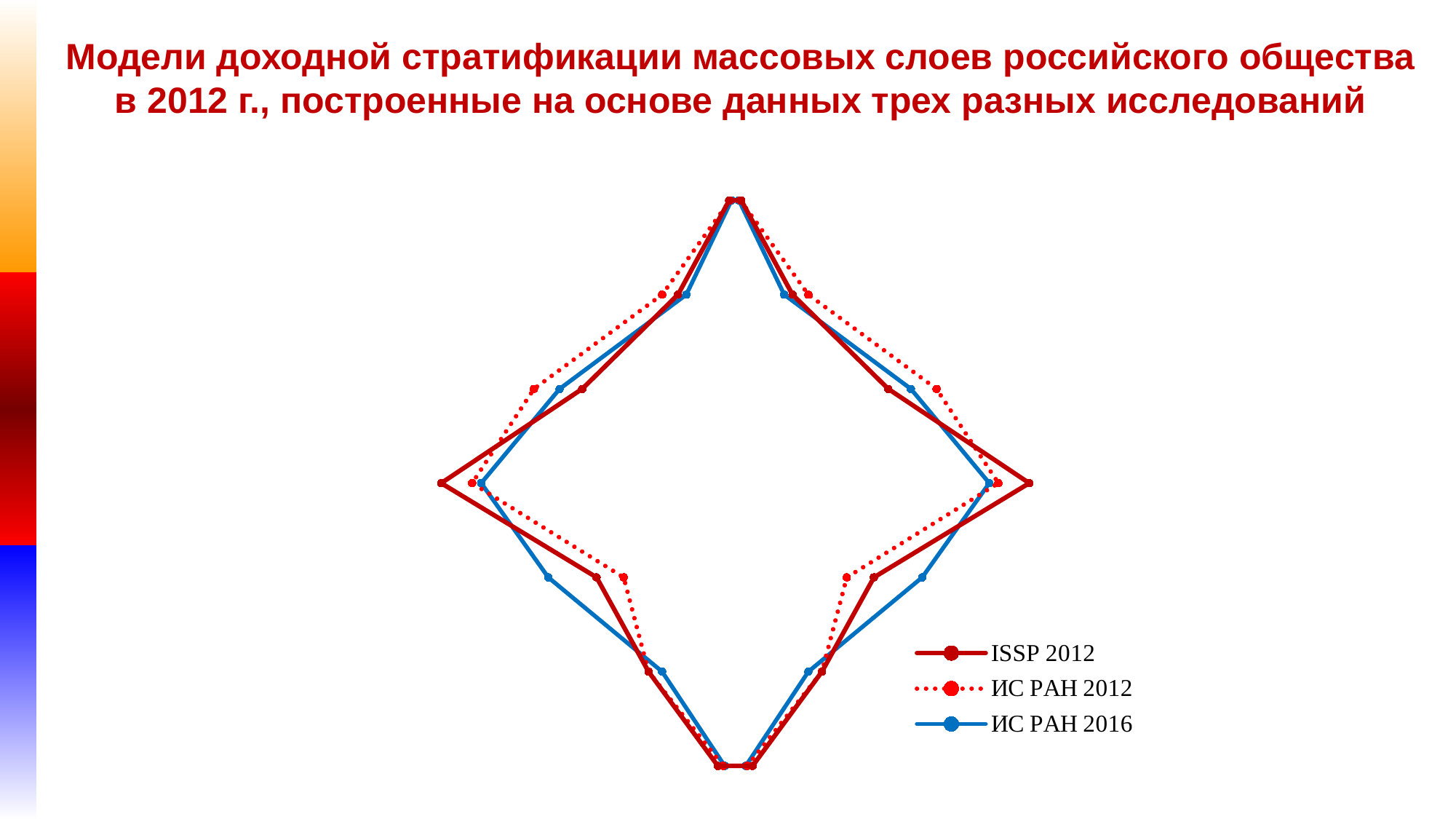
How many series does the chart legend list? 3 Which series in the chart is drawn with a dotted line? ИС РАН 2012 What are the three series named in the chart legend? ISSP 2012, ИС РАН 2012, ИС РАН 2016 Which series extends furthest to the left and right edges of the chart? ISSP 2012